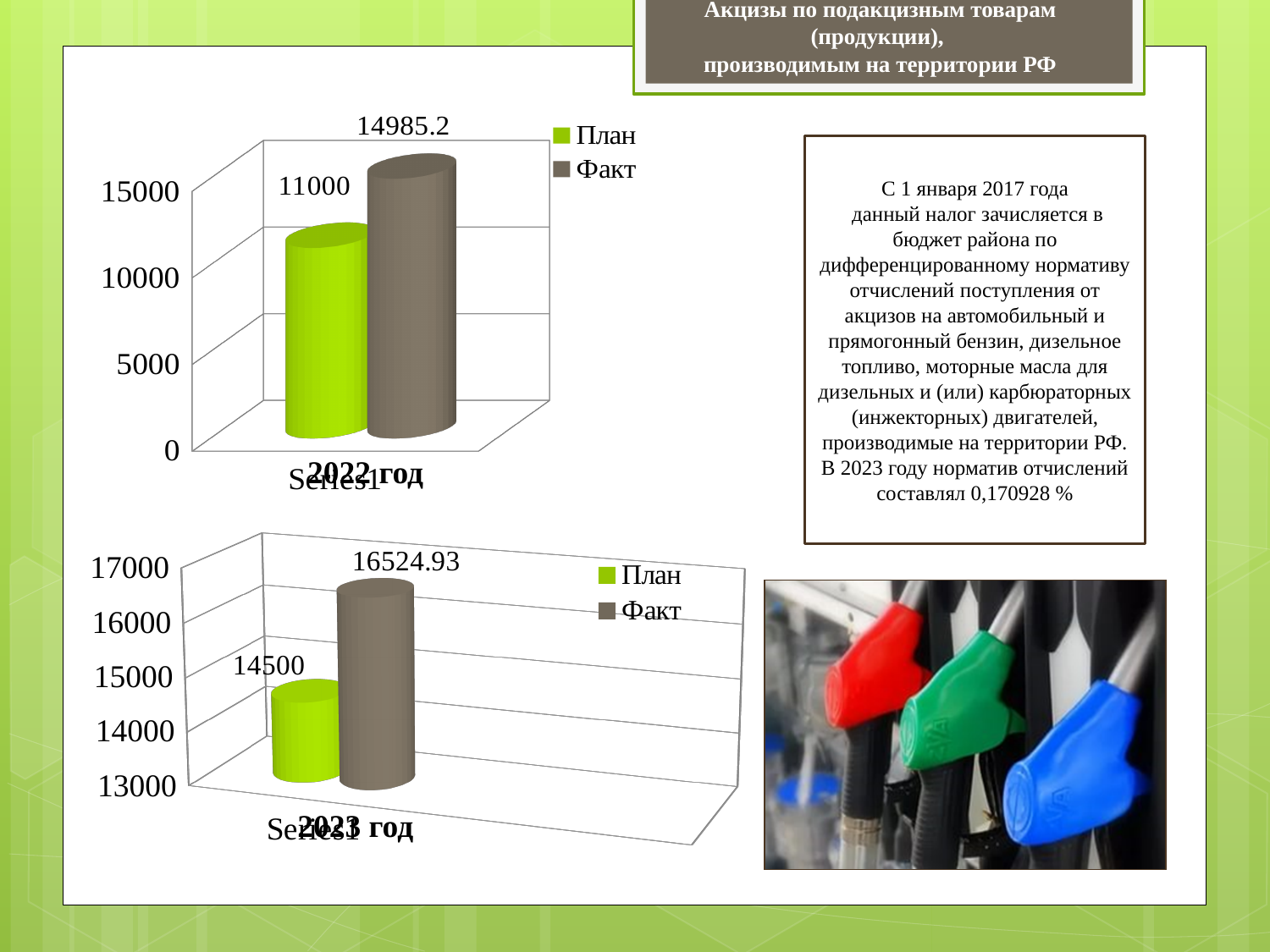
In the bottom chart (2023 год), which series has the lower value? План How many series does the legend of the top chart (2022 год) list? 2 In the top chart (2022 год), what is the value for Факт? 14985.2 In the bottom chart (2023 год), is the value for Факт greater or less than 16000? greater In the top chart (2022 год), what is the value for План? 11000 In the bottom chart (2023 год), what colour is the Факт bar? grey-brown What kind of chart is the bottom chart (2023 год)? bar chart In the top chart (2022 год), what is the difference between Факт and План? 3985.2 In the top chart (2022 год), which series has the higher value, План or Факт? Факт In the bottom chart (2023 год), what is the difference between Факт and План? 2024.93 In the bottom chart (2023 год), what is the value for Факт? 16524.93 In the bottom chart (2023 год), what is the value for План? 14500